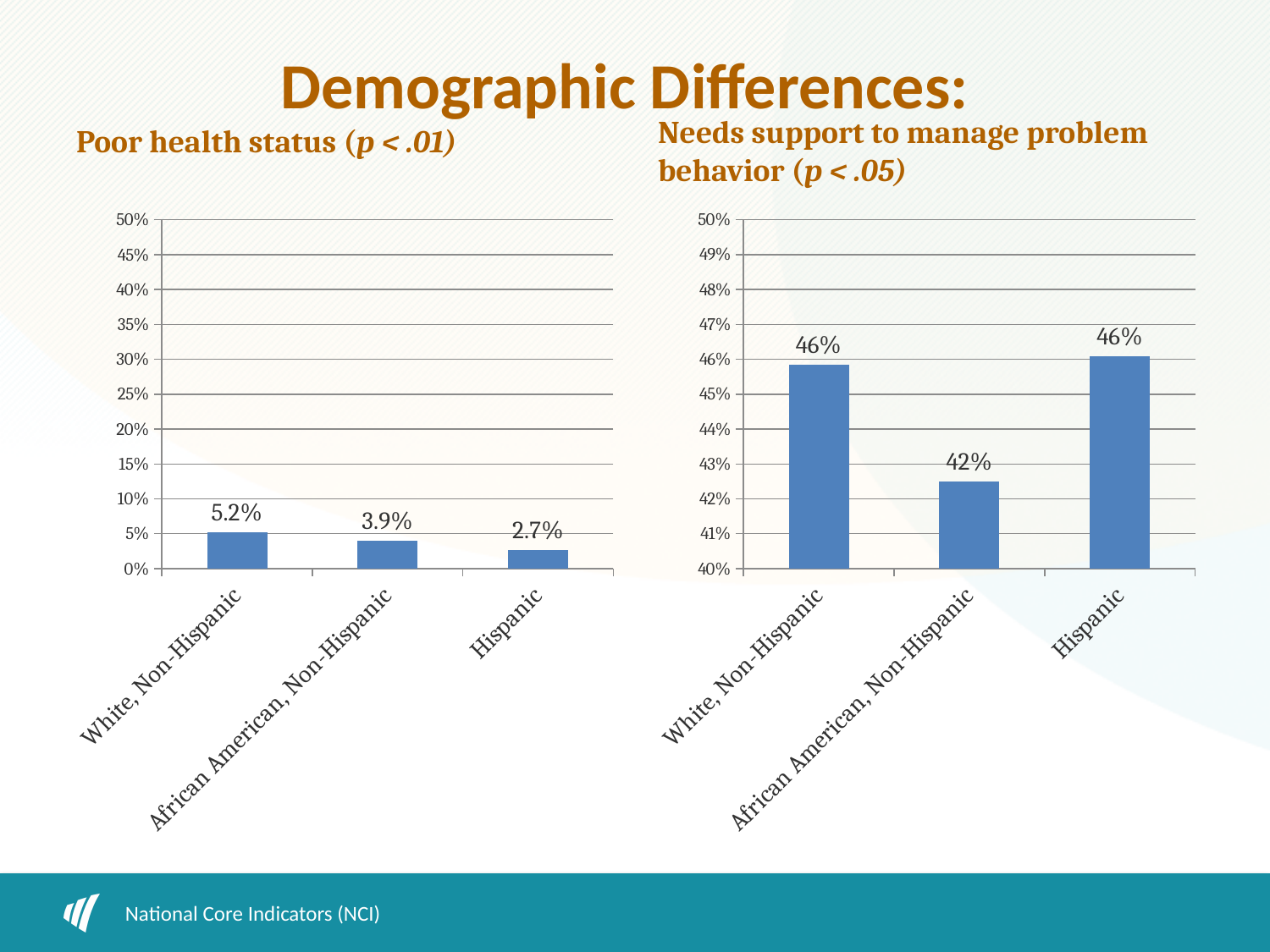
In the 'Needs support to manage problem behavior' chart, is the value for White, Non-Hispanic greater or less than 45%? greater In the 'Needs support to manage problem behavior' chart, which is larger, the value for Hispanic or the value for African American, Non-Hispanic? Hispanic How many categories are shown in the 'Needs support to manage problem behavior' chart? 3 What kind of chart is the 'Poor health status' chart? bar chart In the 'Poor health status' chart, do the values rise or fall from left to right along the x axis? fall In the 'Poor health status' chart, which category has the highest value? White, Non-Hispanic In the 'Poor health status' chart, what is the value for Hispanic? 2.7% In the 'Poor health status' chart, which category has the lowest value? Hispanic In the 'Needs support to manage problem behavior' chart, what is the value for African American, Non-Hispanic? 42% In the 'Poor health status' chart, what is the difference between the values for White, Non-Hispanic and African American, Non-Hispanic? 1.3% In the 'Needs support to manage problem behavior' chart, which category has the lowest value? African American, Non-Hispanic In the 'Poor health status' chart, what is the value for White, Non-Hispanic? 5.2%